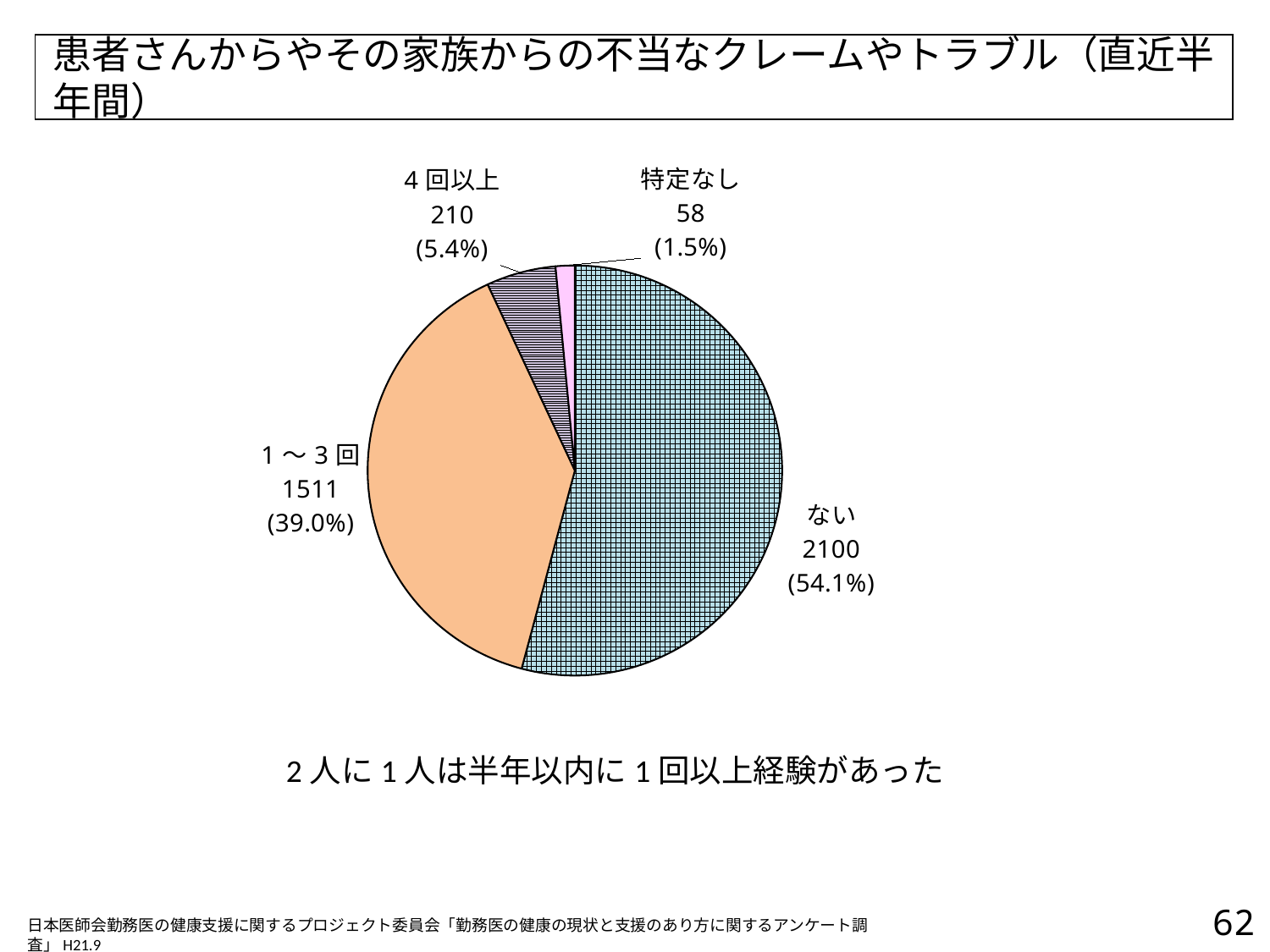
What is the title of the chart? 患者さんからやその家族からの不当なクレームやトラブル（直近半年間） What is the count for the 4回以上 slice? 210 What is the difference in count between ない and 1～3回? 589 Which slice is the largest? ない Which slice is the smallest? 特定なし What kind of chart is shown on the slide? pie chart How many slices does the pie chart have? 4 Which is larger, the count for 4回以上 or the count for 特定なし? 4回以上 What percentage share does the 1～3回 slice have? 39.0% What is the percentage share of the ない slice? 54.1% What is the count for the ない slice? 2100 What percentage share does the 特定なし slice have? 1.5%